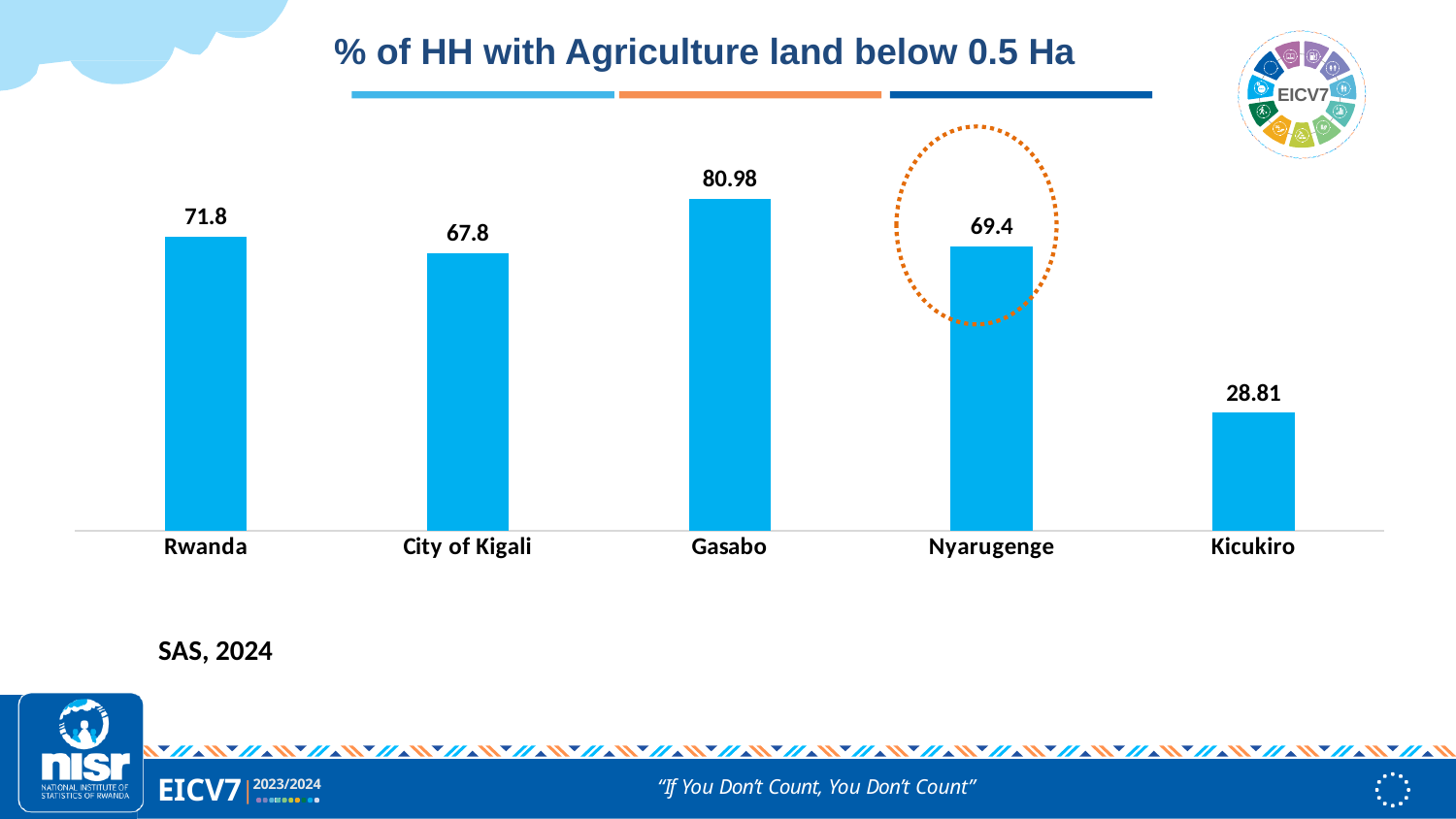
What is the value for Gasabo? 80.98 What is the title of the chart? % of HH with Agriculture land below 0.5 Ha What is the value for Rwanda? 71.8 What is the value for Nyarugenge? 69.4 What is the value for Kicukiro? 28.81 Which category has the lowest value? Kicukiro What kind of chart is shown on the slide? Bar chart What is the difference between the values for Gasabo and Kicukiro? 52.17 How many categories are shown in the chart? 5 What is the difference between the values for Rwanda and City of Kigali? 4 Which category has the highest value? Gasabo Which is larger, the value for Rwanda or the value for Nyarugenge? Rwanda